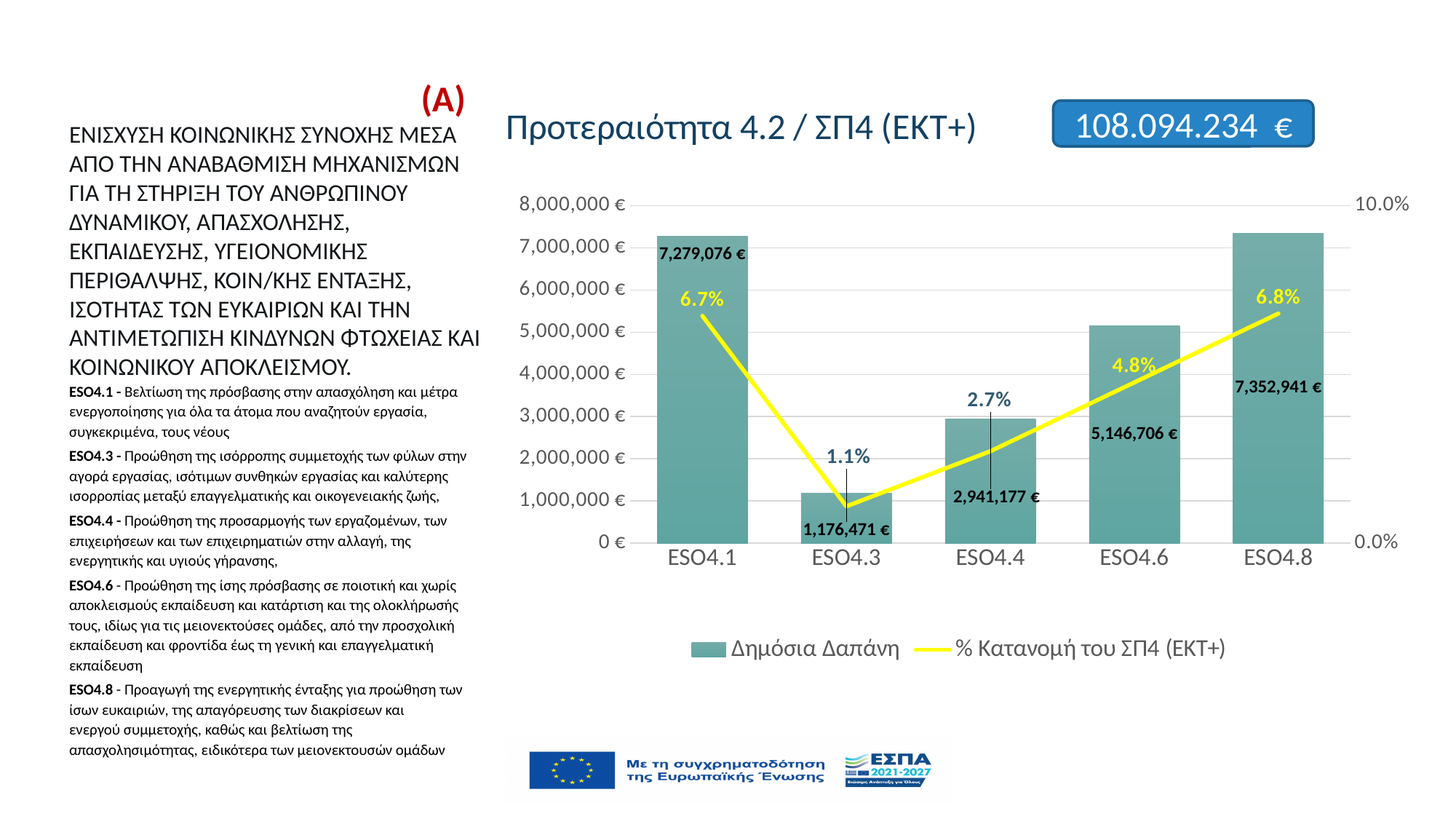
Is the Δημόσια Δαπάνη for ESO4.6 greater or less than 4,000,000 €? greater What percentage (% Κατανομή του ΣΠ4) is shown for ESO4.6? 4.8% What is the Δημόσια Δαπάνη value for ESO4.1? 7,279,076 € Which has a larger Δημόσια Δαπάνη, ESO4.1 or ESO4.6? ESO4.1 How many categories are shown on the x axis? 5 How many series does the legend list? 2 What percentage (% Κατανομή του ΣΠ4) is shown for ESO4.4? 2.7% Which category has the lowest Δημόσια Δαπάνη? ESO4.3 What is the title of the chart? Προτεραιότητα 4.2 / ΣΠ4 (ΕΚΤ+) What is the Δημόσια Δαπάνη value for ESO4.3? 1,176,471 € Which category has the highest Δημόσια Δαπάνη? ESO4.8 What is the difference in Δημόσια Δαπάνη between ESO4.6 and ESO4.4? 2,205,529 €